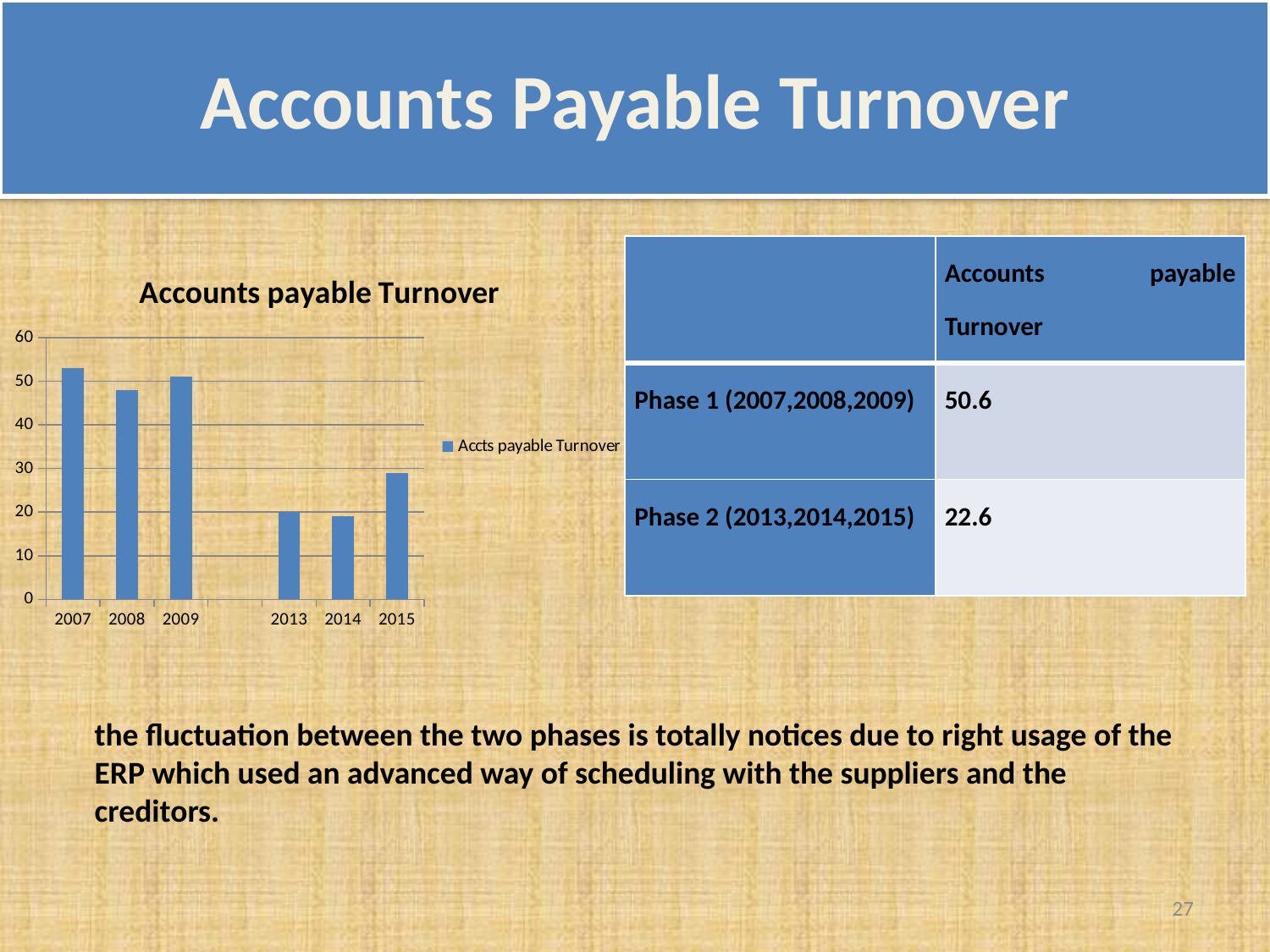
Which year has the highest accounts payable turnover in the chart? 2007 Which year has the larger value, 2014 or 2015? 2015 What kind of chart is shown on the slide? bar chart Is the value for 2007 greater or less than 50? greater Is the value for 2008 greater or less than 50? less Is the value for 2015 greater or less than 20? greater How many series does the chart legend list? 1 Which year has the larger value, 2007 or 2013? 2007 What is the legend entry of the chart? Accts payable Turnover How many years are shown on the x axis of the chart? 6 What is the title of the chart? Accounts payable Turnover